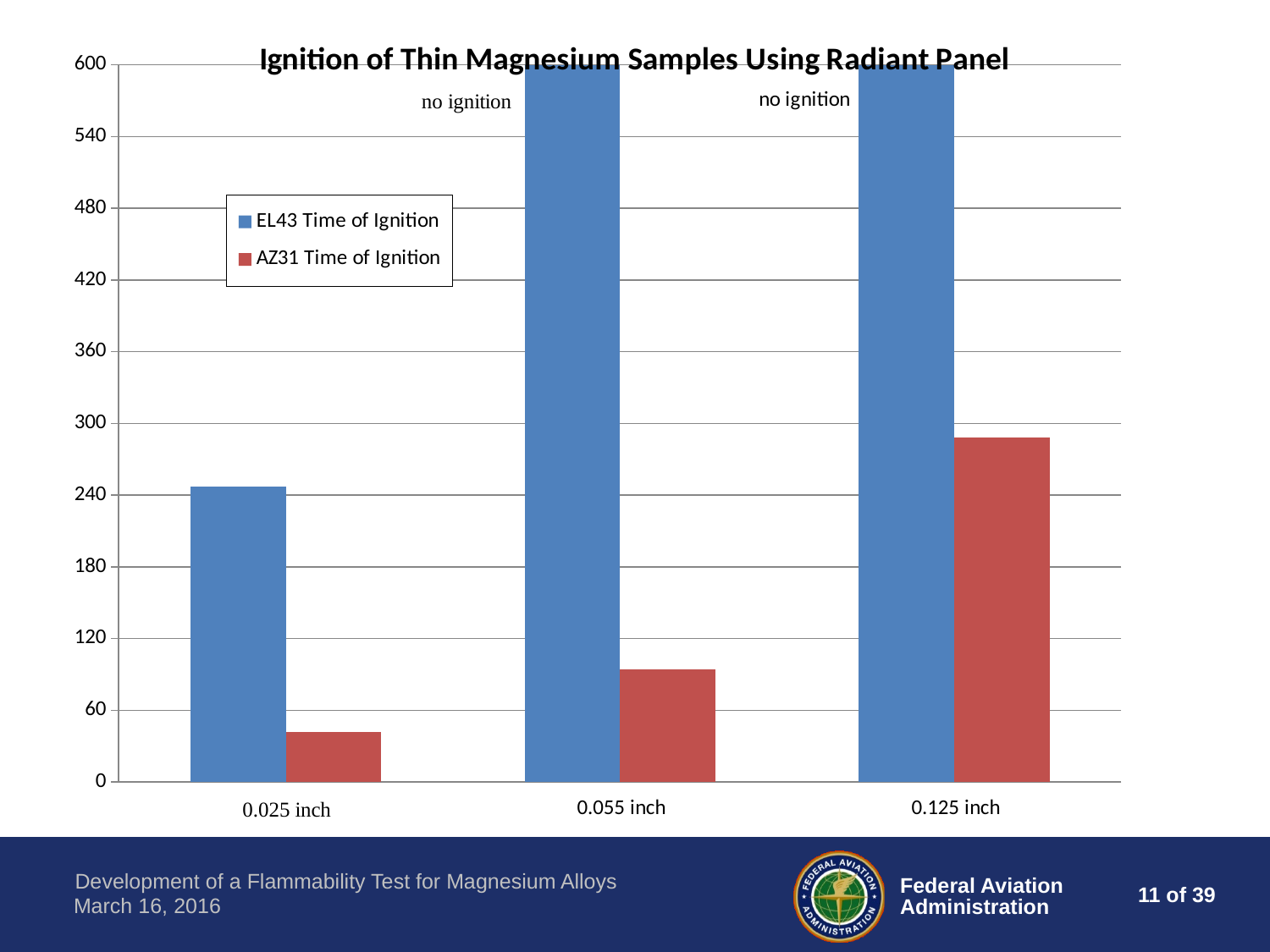
Which thickness has the highest AZ31 Time of Ignition? 0.125 inch Is the EL43 Time of Ignition value for 0.025 inch greater or less than 300? less Which thickness has the lowest AZ31 Time of Ignition? 0.025 inch How many sample thickness categories are shown on the x axis? 3 Is the AZ31 Time of Ignition value for 0.125 inch greater or less than 240? greater What is the title of the chart? Ignition of Thin Magnesium Samples Using Radiant Panel Is the AZ31 Time of Ignition value for 0.025 inch greater or less than 60? less What kind of chart is shown on the slide? bar chart How many series does the legend list? 2 Which series is shown in red? AZ31 Time of Ignition Do the AZ31 Time of Ignition values rise or fall as thickness increases along the x axis? rise